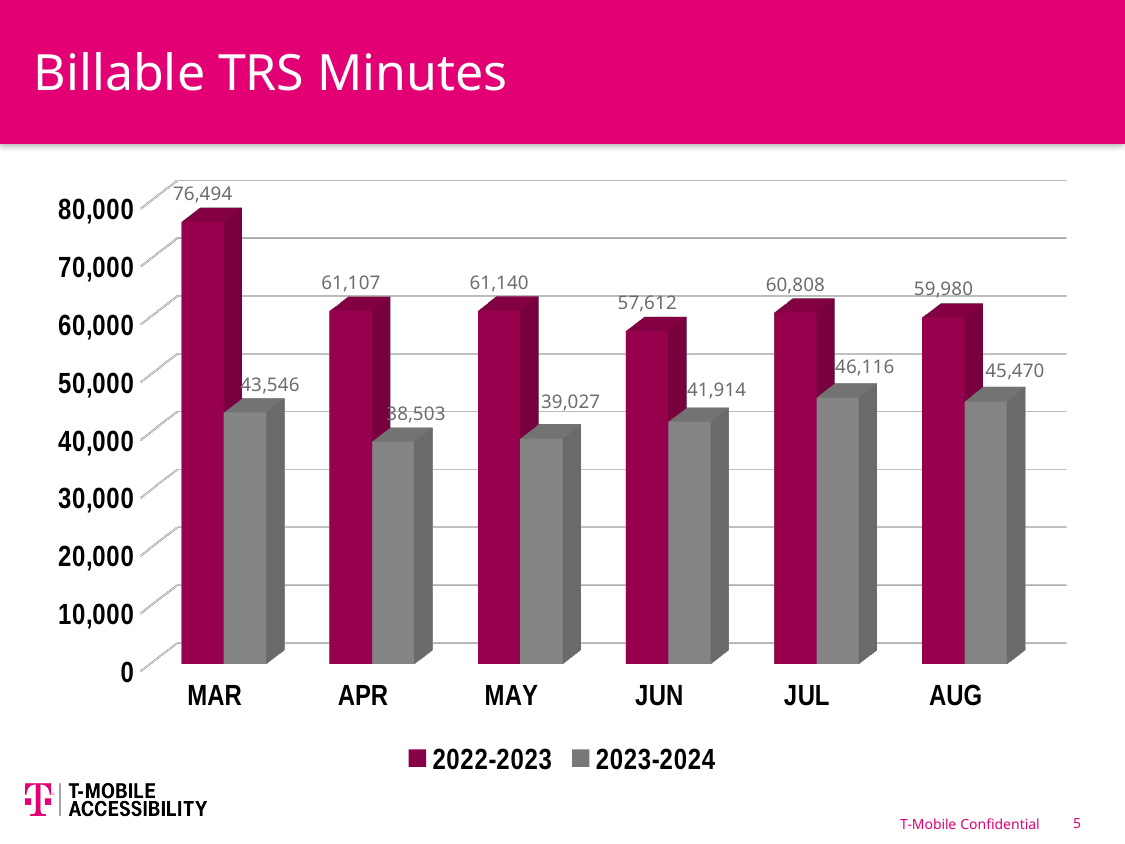
How many series does the legend list? 2 What is the value for JUL in the 2023-2024 series? 46,116 What is the difference between the 2022-2023 and 2023-2024 values for MAR? 32,948 What is the difference between the 2023-2024 values for JUL and AUG? 646 Which month has the lowest value in the 2023-2024 series? APR How many months are shown on the x axis? 6 What is the value for MAR in the 2022-2023 series? 76,494 Which is larger, the 2023-2024 value for JUN or the 2023-2024 value for MAY? JUN Which month has the highest value in the 2022-2023 series? MAR Is the 2022-2023 value for AUG greater or less than 50,000? greater What is the value for JUN in the 2022-2023 series? 57,612 What kind of chart is shown on the slide? Bar chart